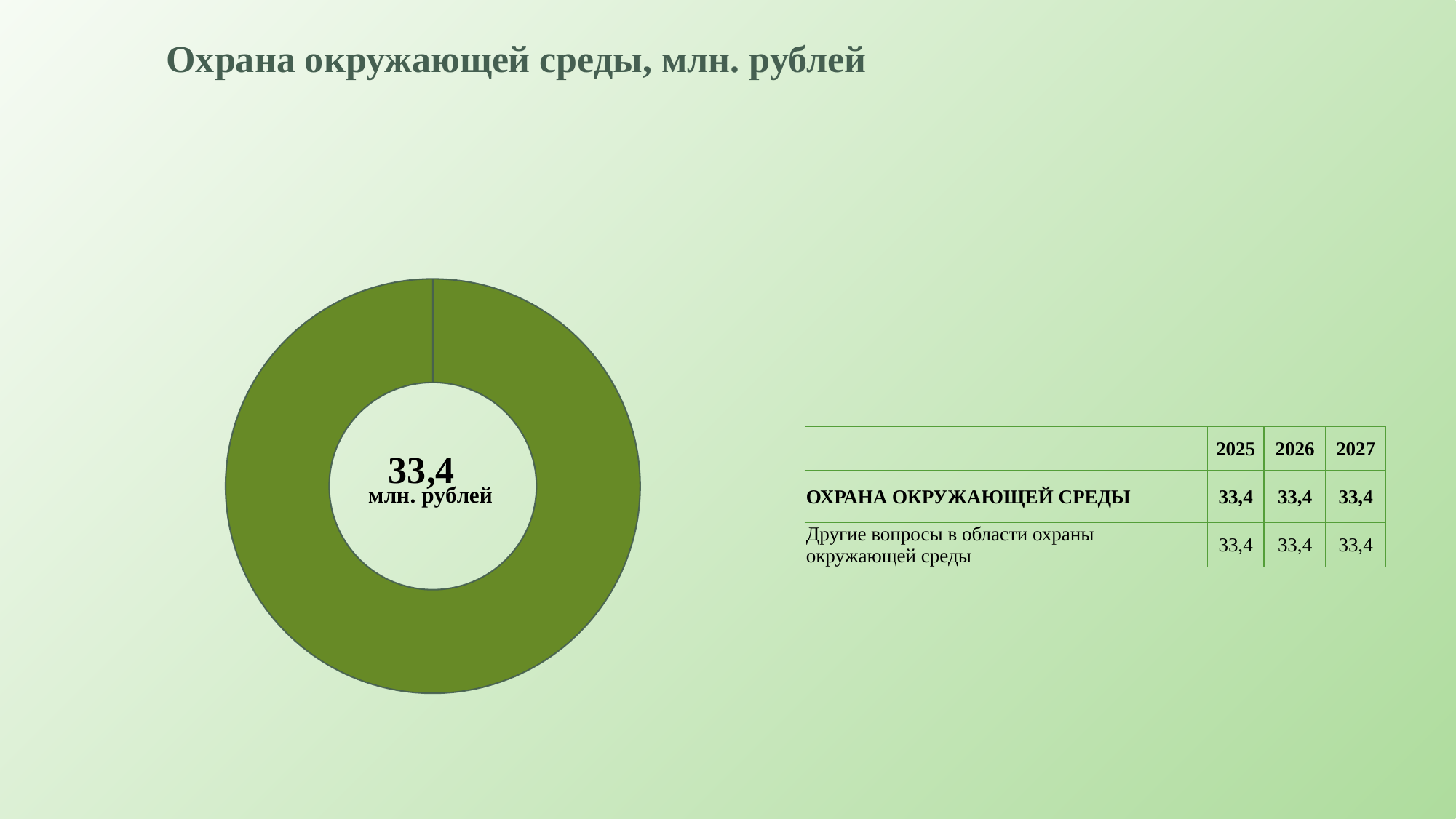
Is the value shown in the centre of the doughnut chart greater or less than 40? less How many slices does the doughnut chart have? 1 What kind of chart is shown on the slide? doughnut chart What value is printed in the centre of the doughnut chart? 33,4 What unit is printed under the value in the centre of the doughnut chart? млн. рублей Is the value shown in the centre of the doughnut chart greater or less than 30? greater What colour is the slice of the doughnut chart? green What share of the doughnut chart does the single slice take up? 100%